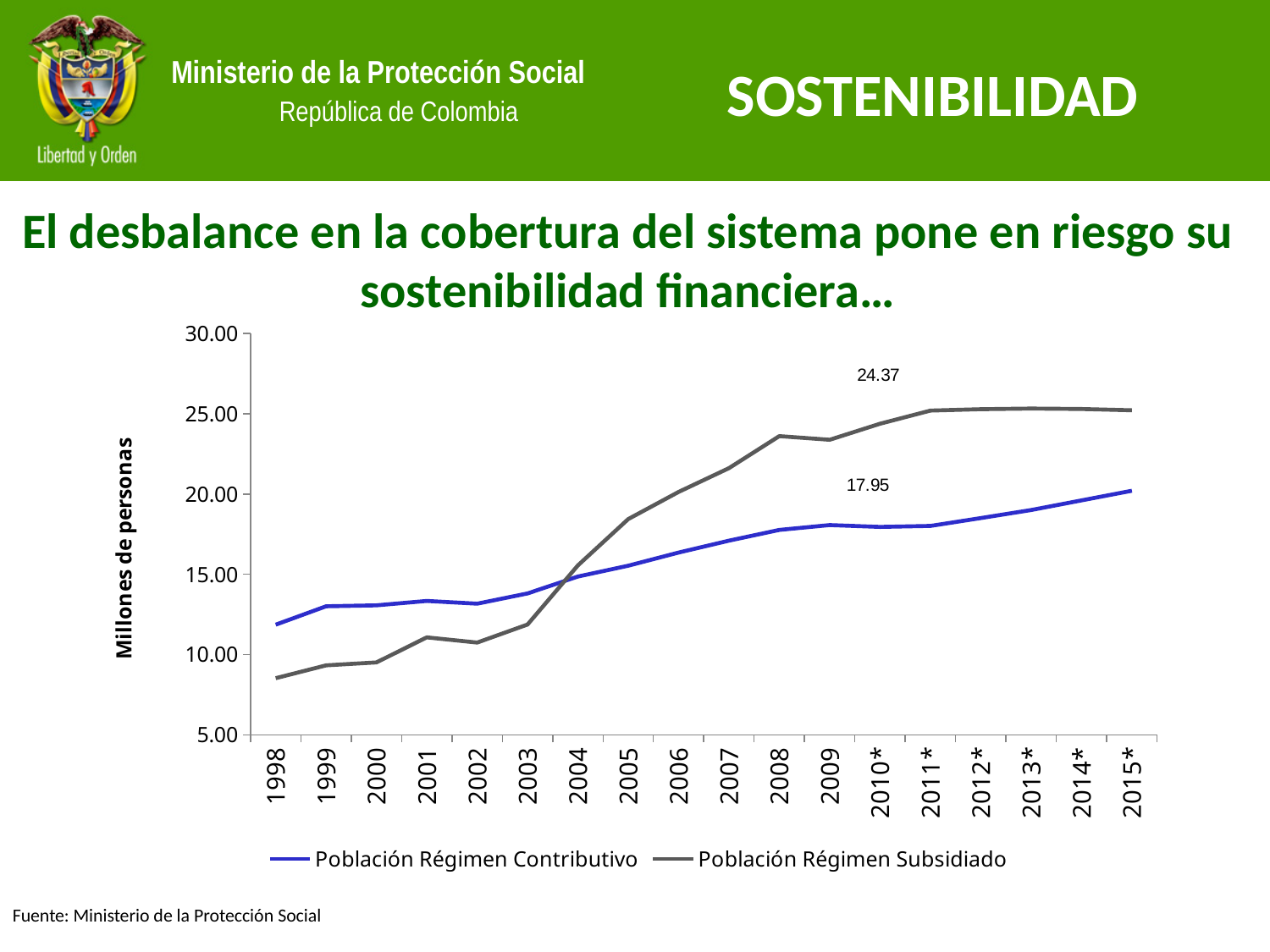
Does the Población Régimen Subsidiado line rise or fall between 1998 and 2011*? rise What is the label on the y axis of the chart? Millones de personas How many series does the legend list? 2 Is the value for Población Régimen Subsidiado in 1998 greater or less than 10.00? less What type of chart is shown on the slide? line chart How many years are shown on the x axis? 18 In 1998, which series has the larger value, Población Régimen Contributivo or Población Régimen Subsidiado? Población Régimen Contributivo In 2010*, which series has the larger value, Población Régimen Contributivo or Población Régimen Subsidiado? Población Régimen Subsidiado What is the difference between the labelled values for Población Régimen Subsidiado and Población Régimen Contributivo in 2010*? 6.42 What is the labelled value for Población Régimen Subsidiado in 2010*? 24.37 What is the labelled value for Población Régimen Contributivo in 2010*? 17.95 Is the value for Población Régimen Subsidiado in 2008 greater or less than 20.00? greater